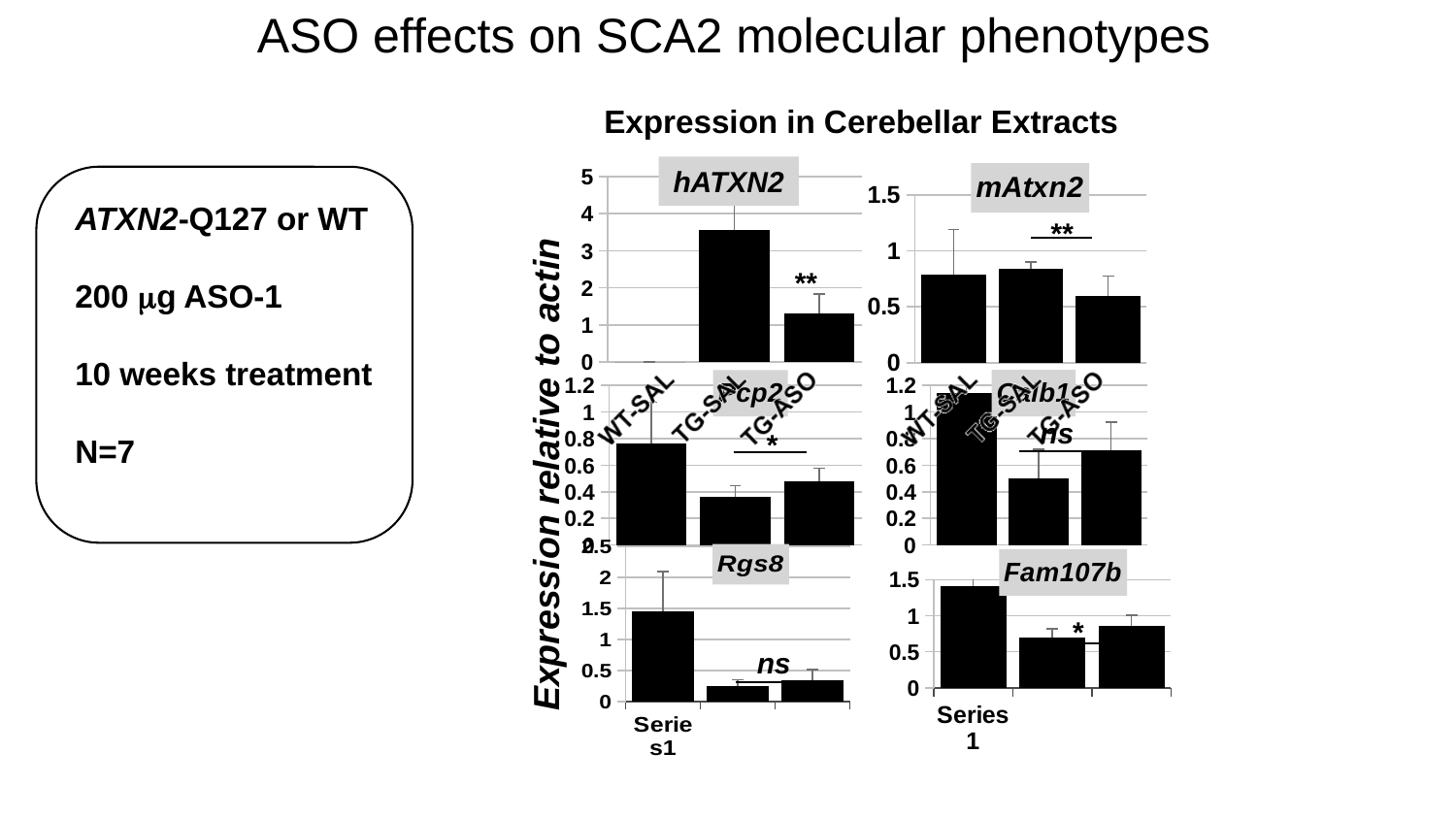
In the Rgs8 chart, is the value of the second bar greater or less than 0.5? less In the mAtxn2 chart, is the value for TG-SAL greater or less than 1? less In the mAtxn2 chart, which category has the lowest bar? TG-ASO In the hATXN2 chart, is the value for TG-ASO greater or less than 2? less In the Pcp2 chart, is the first bar larger or smaller than the second bar? larger In the Rgs8 chart, which bar is the highest: the first, second or third? the first In the hATXN2 chart, which category has the highest bar? TG-SAL